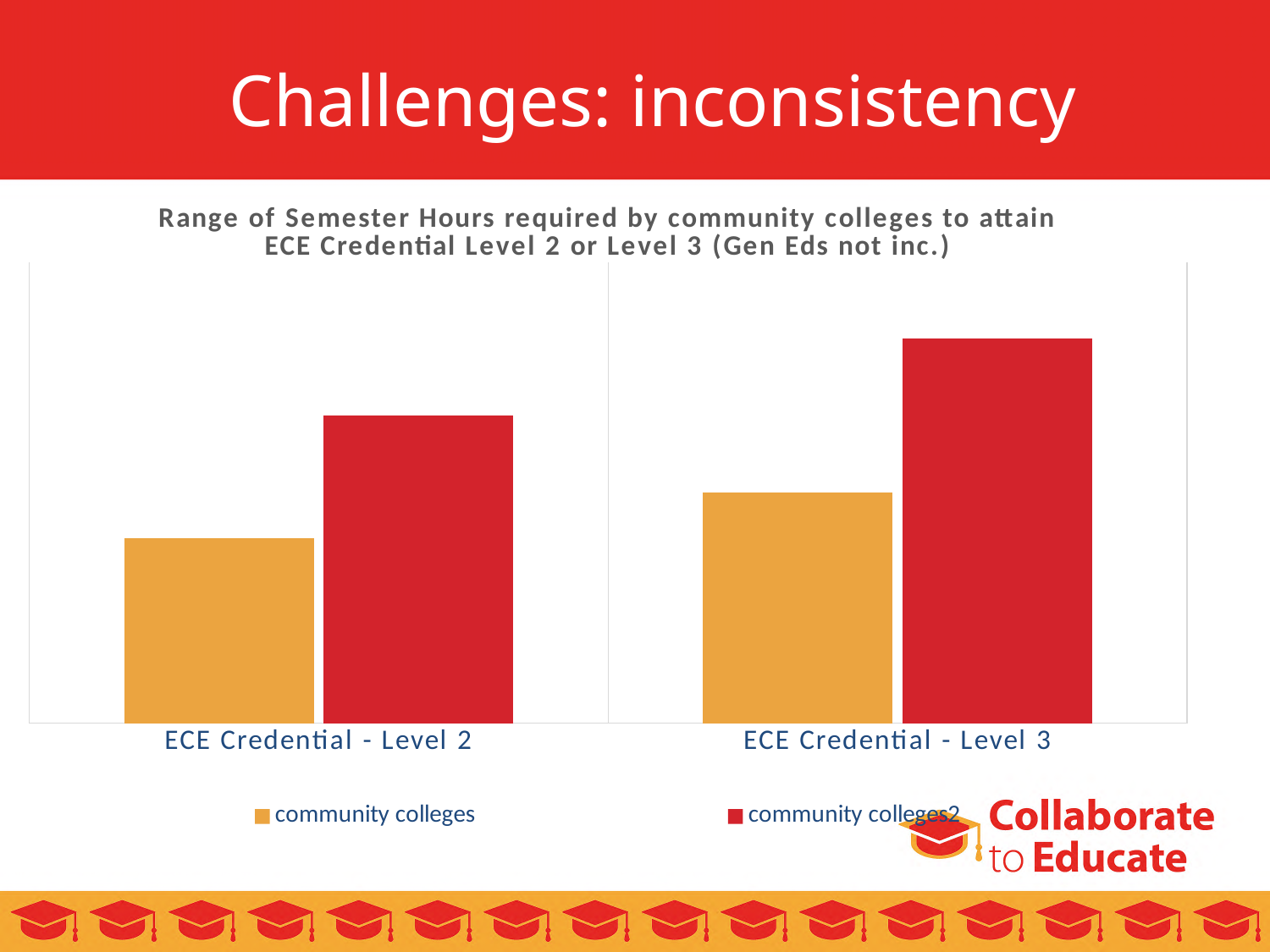
What kind of chart is shown on the slide? bar chart Do the values for the community colleges series rise or fall from ECE Credential - Level 2 to ECE Credential - Level 3? rise Which bar is the tallest in the whole chart? community colleges2 for ECE Credential - Level 3 For the community colleges2 series, which category has the lower value? ECE Credential - Level 2 How many categories are shown on the x axis of the chart? 2 Which bar is the shortest in the whole chart? community colleges for ECE Credential - Level 2 For the community colleges series, which category has the higher value? ECE Credential - Level 3 For ECE Credential - Level 3, which series has the larger value, community colleges or community colleges2? community colleges2 What are the two series named in the legend? community colleges and community colleges2 For ECE Credential - Level 2, which series has the larger value, community colleges or community colleges2? community colleges2 How many series does the chart's legend list? 2 What is the title of the chart? Range of Semester Hours required by community colleges to attain ECE Credential Level 2 or Level 3 (Gen Eds not inc.)